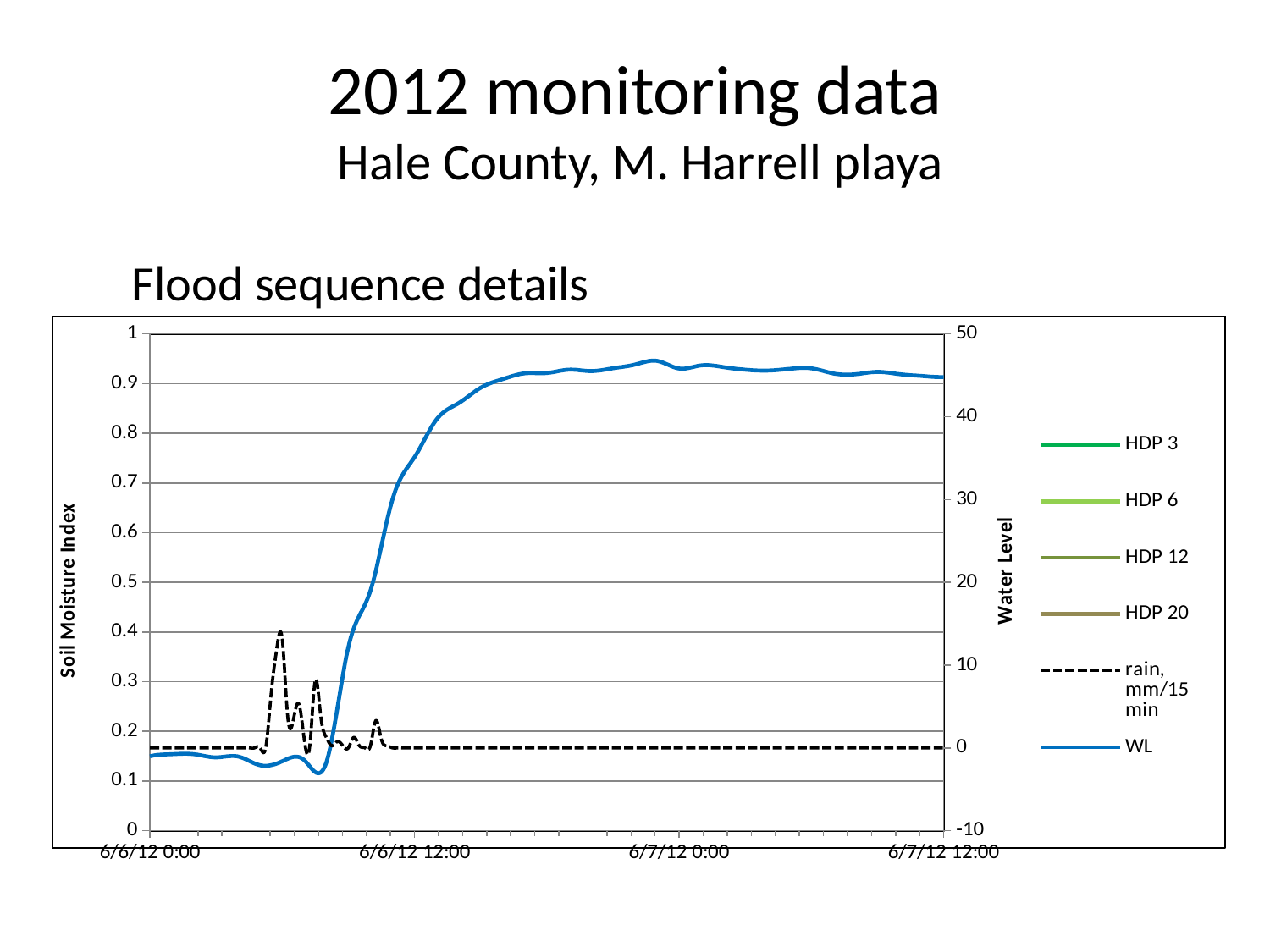
What kind of chart is shown on the slide? line chart On the Water Level axis, is the WL value at 6/7/12 0:00 greater or less than 40? greater Does the WL series rise or fall between 6/6/12 0:00 and 6/7/12 0:00? rise Which series reaches a higher value at 6/7/12 0:00, WL or rain, mm/15 min? WL What is the title of the right-hand vertical axis? Water Level Which series in the legend is drawn with a dashed line? rain, mm/15 min On the Water Level axis, is the WL value at 6/6/12 0:00 greater or less than 10? less What is the maximum value shown on the Water Level axis? 50 How many series does the chart's legend list? 6 On the Water Level axis, is the WL value at 6/7/12 12:00 greater or less than 40? greater